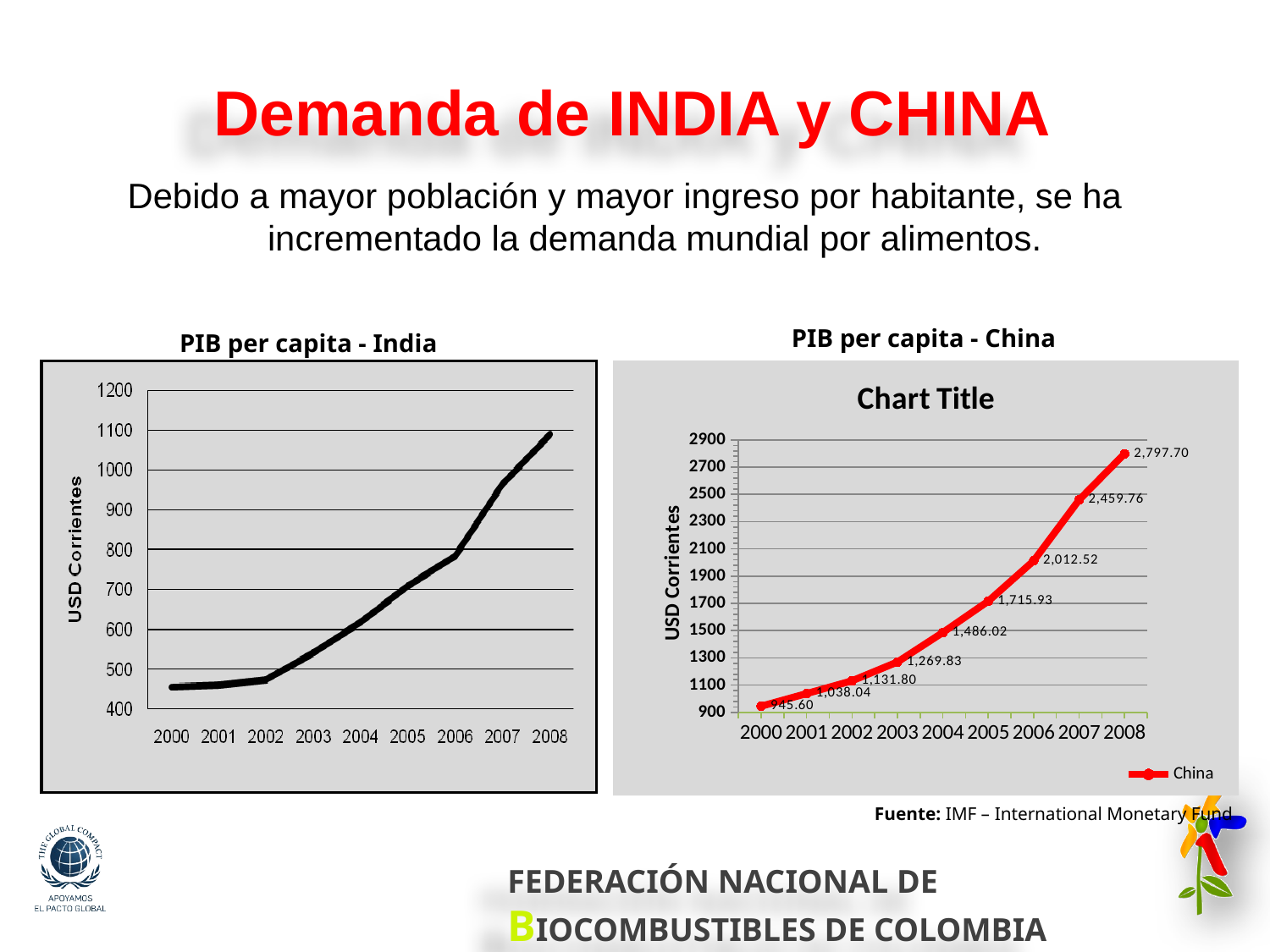
On the 'PIB per capita - China' chart, what is the difference between the 2008 value and the 2007 value? 337.94 On the 'PIB per capita - India' chart, is the value for 2008 greater or less than 1000? greater What kind of chart is the 'PIB per capita - India' chart? line chart On the 'PIB per capita - India' chart, do the values rise or fall from 2000 to 2008? rise On the 'PIB per capita - China' chart, what is the value for 2005? 1,715.93 On the 'PIB per capita - India' chart, is the value for 2000 greater or less than 500? less On the 'PIB per capita - China' chart, how many series does the legend list? 1 On the 'PIB per capita - China' chart, what is the value for 2000? 945.60 On the 'PIB per capita - China' chart, what is the value for 2008? 2,797.70 On the 'PIB per capita - China' chart, which year has the lowest value? 2000 On the 'PIB per capita - China' chart, which year has the highest value? 2008 On the 'PIB per capita - China' chart, how many years are plotted? 9